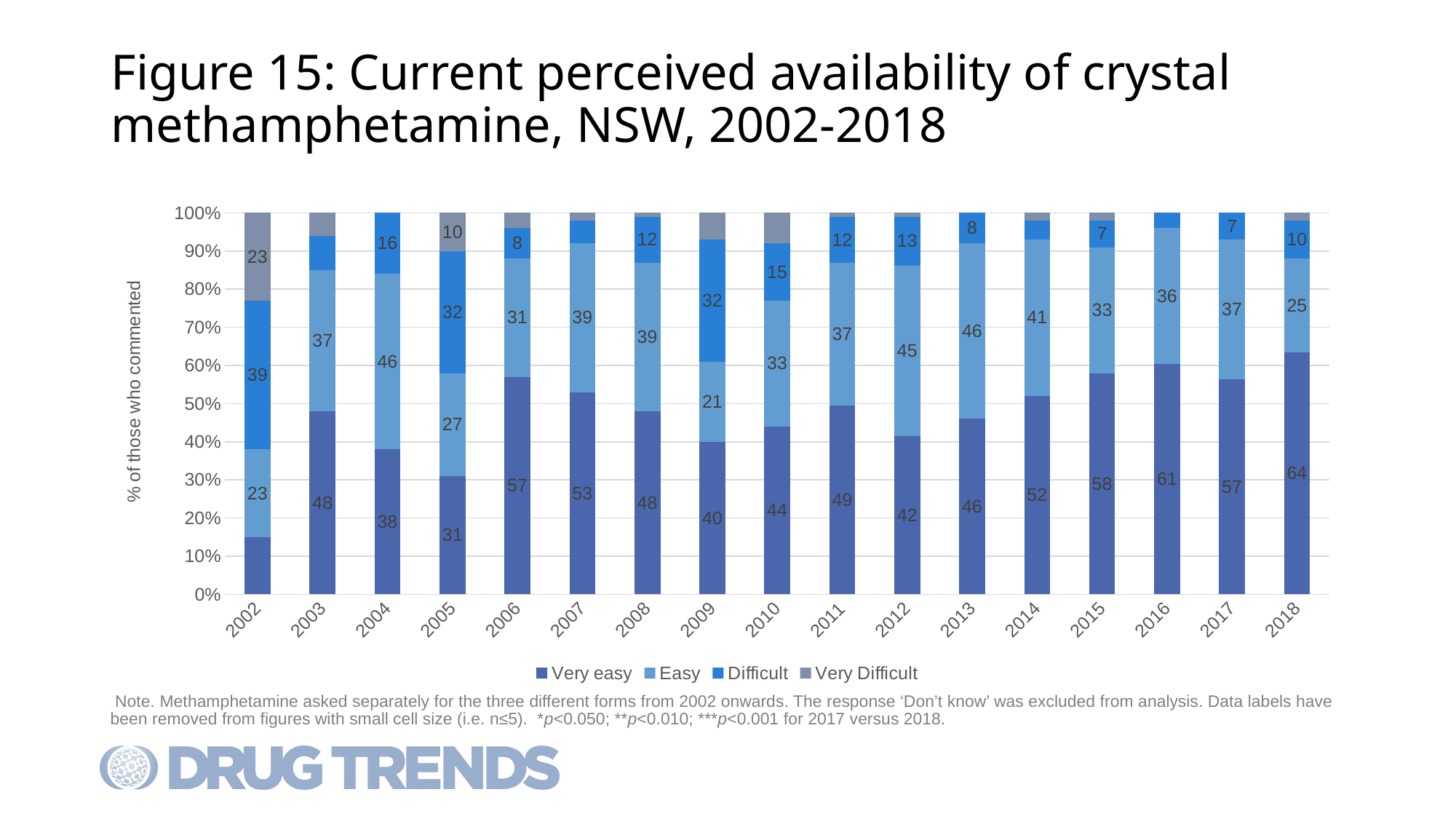
How many series does the legend list? 4 In which year is the 'Very easy' segment the largest? 2018 What percentage of respondents rated crystal methamphetamine as 'Very easy' to obtain in 2018? 64 What is the 'Very Difficult' value for 2002? 23 What kind of chart is shown on the slide? Stacked bar chart In which year is the 'Very easy' segment the smallest? 2002 What is the 'Easy' value for 2004? 46 By how much did the 'Very easy' value increase from 2017 to 2018? 7 What is the 'Difficult' value for 2005? 32 In 2012, which is larger: the 'Very easy' segment or the 'Easy' segment? Easy How many years are shown on the x axis? 17 Is the 'Very easy' value for 2002 greater or less than 20%? less